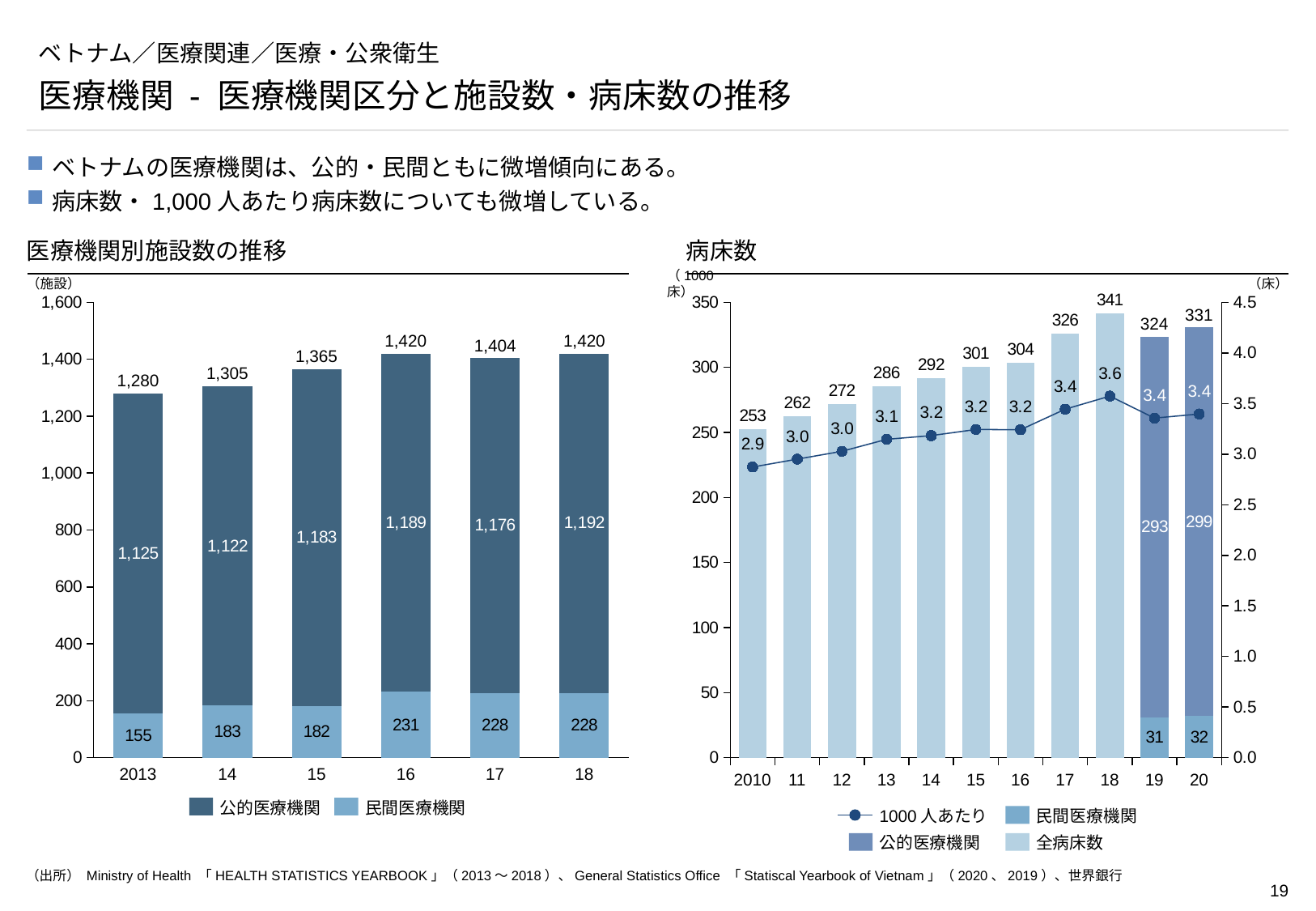
In the 医療機関別施設数の推移 chart, what is the total of the stacked bar for 15? 1,365 In the 病床数 chart, which year has the highest total number of beds? 18 In the 医療機関別施設数の推移 chart, what is the value for 民間医療機関 in 16? 231 In the 医療機関別施設数の推移 chart, how many series does the legend list? 2 In the 病床数 chart, what is the 公的医療機関 value for 20? 299 In the 病床数 chart, what is the 1000人あたり value for 18? 3.6 In the 病床数 chart, how many years are shown on the x axis? 11 In the 病床数 chart, is the total bed count for 19 larger or smaller than for 18? smaller In the 医療機関別施設数の推移 chart, what is the value for 公的医療機関 in 2013? 1,125 In the 医療機関別施設数の推移 chart, which year has the lowest total number of facilities? 2013 In the 医療機関別施設数の推移 chart, what is the difference between the 民間医療機関 values for 14 and 2013? 28 In the 病床数 chart, what is the 全病床数 value for 2010? 253